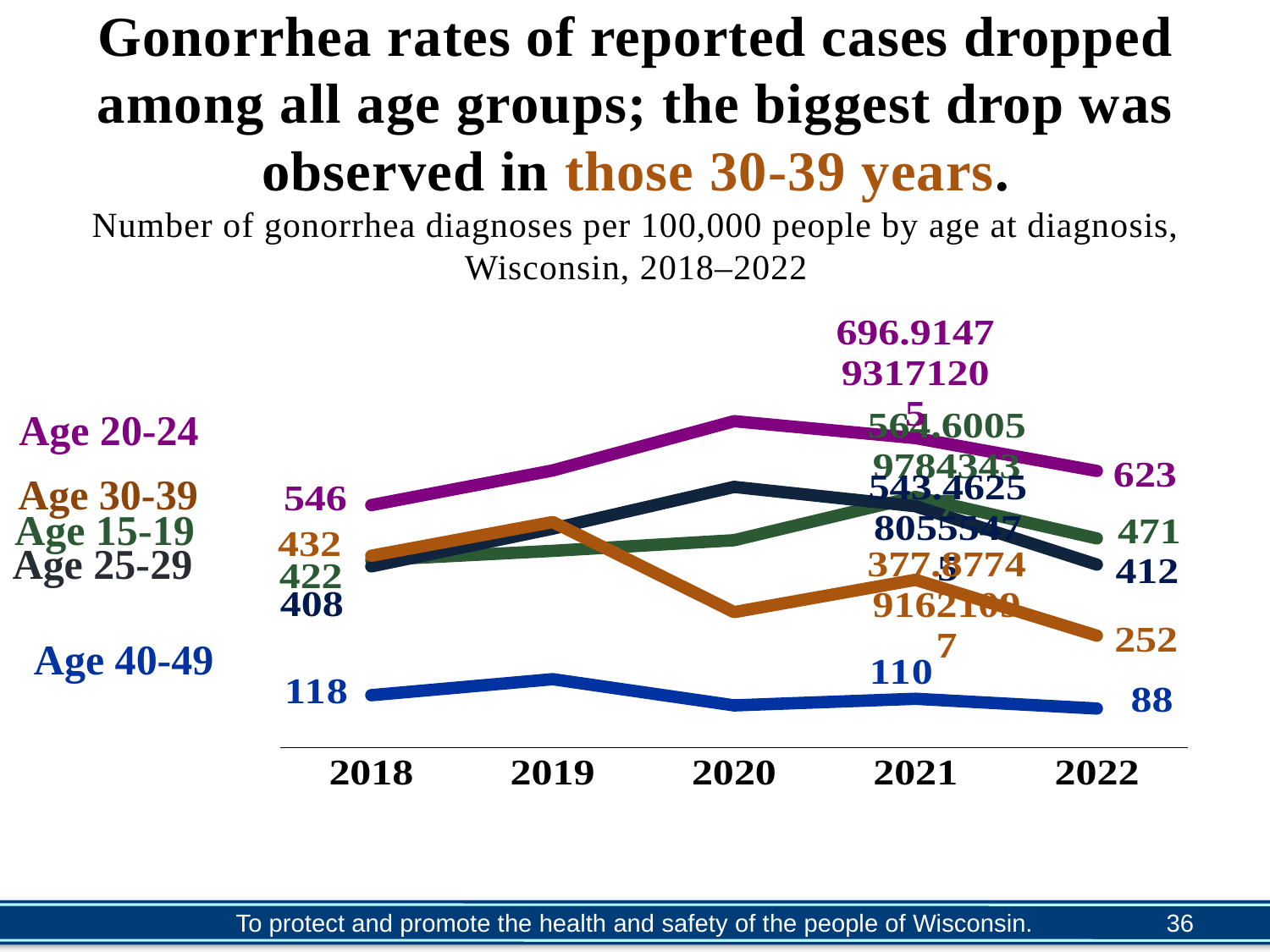
What was the gonorrhea rate for Age 20-24 in 2018? 546 What was the gonorrhea rate for Age 40-49 in 2018? 118 How many age-group series are plotted on the chart? 5 Which age group had the lowest rate in 2018? Age 40-49 By how much did the rate for Age 30-39 fall from 2018 to 2022? 180 How many years are shown along the x axis of the chart? 5 What type of chart is shown on the slide? Line chart Which age group had the highest rate in 2022? Age 20-24 What was the gonorrhea rate for Age 30-39 in 2022? 252 Did the rate for Age 40-49 rise or fall from 2018 to 2022? Fall What was the gonorrhea rate for Age 15-19 in 2022? 471 Which was larger in 2022, the rate for Age 25-29 or the rate for Age 30-39? Age 25-29